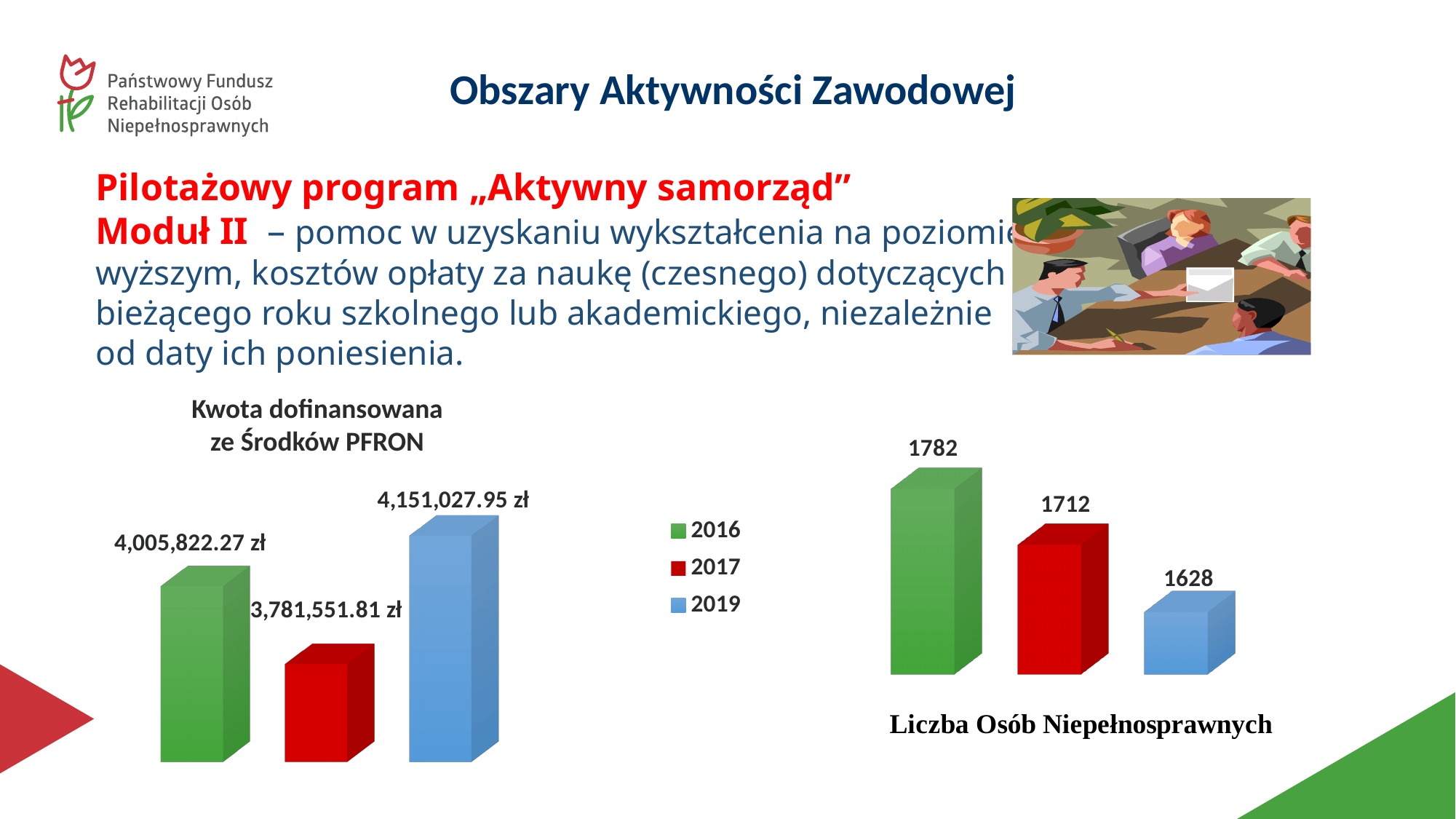
What kind of chart is the chart titled "Liczba Osób Niepełnosprawnych"? bar chart In the chart titled "Liczba Osób Niepełnosprawnych", what is the difference between the 2016 and 2019 values? 154 In the chart titled "Kwota dofinansowana ze Środków PFRON", which year has the highest value? 2019 In the chart titled "Kwota dofinansowana ze Środków PFRON", what is the value for 2016? 4,005,822.27 zł In the chart titled "Liczba Osób Niepełnosprawnych", do the values rise or fall from 2016 to 2019? fall In the chart titled "Liczba Osób Niepełnosprawnych", what is the value for 2019? 1628 In the chart titled "Kwota dofinansowana ze Środków PFRON", what is the value for 2017? 3,781,551.81 zł In the chart titled "Kwota dofinansowana ze Środków PFRON", what is the difference between the 2019 and 2016 values? 145,205.68 zł How many years does the legend between the two charts list? 3 In the chart titled "Kwota dofinansowana ze Środków PFRON", which year has the lowest value? 2017 In the chart titled "Liczba Osób Niepełnosprawnych", which year has the highest value? 2016 In the chart titled "Liczba Osób Niepełnosprawnych", what is the value for 2017? 1712